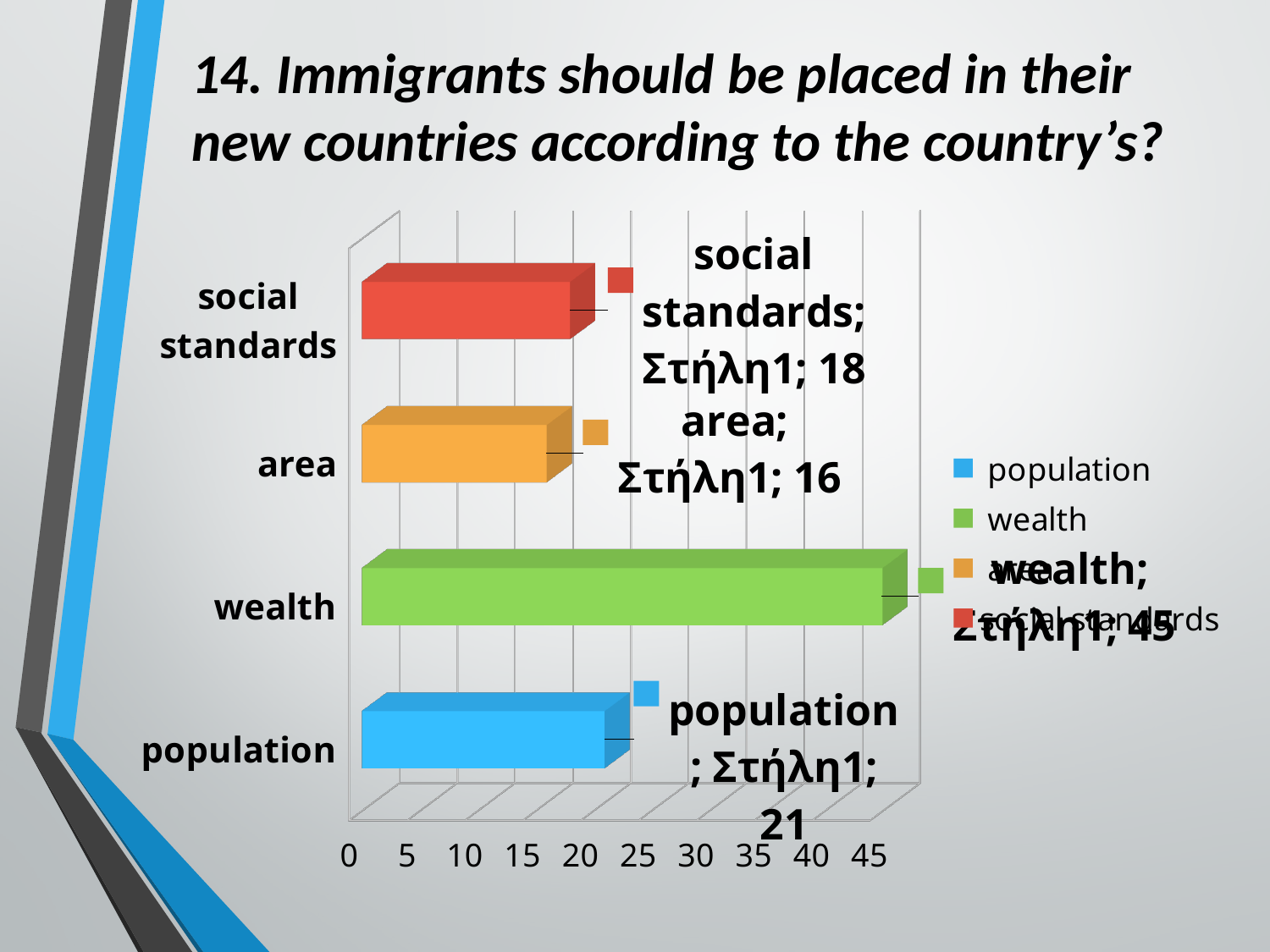
What is the value for social standards? 18 What is the value for population? 21 How many entries does the legend list? 4 Which category has the lowest value? area What is the difference between the values for wealth and population? 24 How many categories are shown in the chart? 4 What is the value for wealth? 45 What is the value for area? 16 What is the difference between the values for social standards and area? 2 Which is larger, the value for population or the value for social standards? population What kind of chart is shown on the slide? bar chart Which category has the highest value? wealth